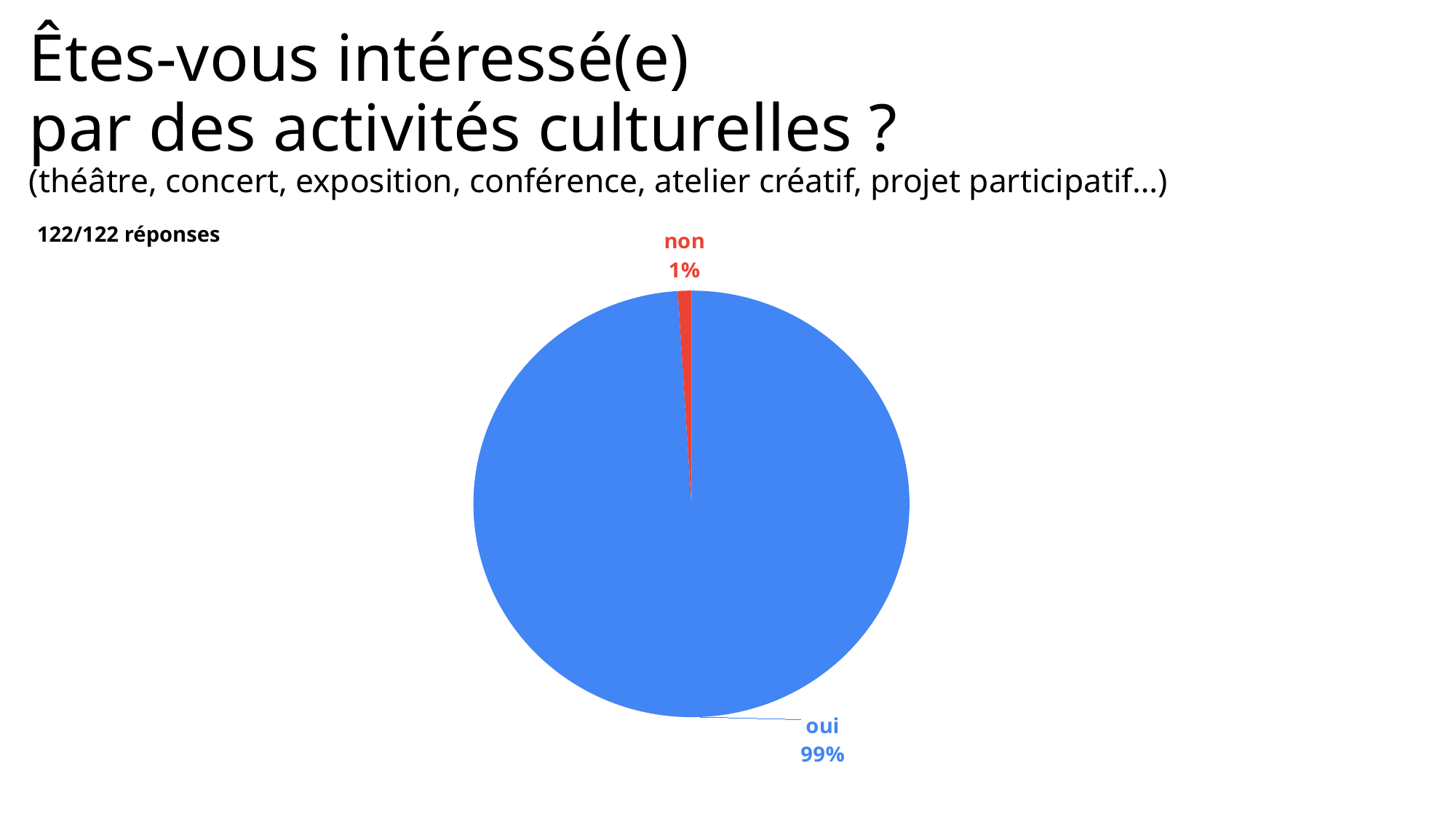
Which is larger, the "oui" slice or the "non" slice? oui Which slice of the pie is the largest? oui How many slices does the pie chart have? 2 What share of the pie does the "oui" slice represent? 99% What share of the pie does the "non" slice represent? 1% How many responses does the slide say the chart is based on? 122/122 réponses What is the difference in percentage points between the "oui" and "non" slices? 98 Which slice of the pie is the smallest? non What colour is the "non" slice? red What kind of chart is shown on the slide? pie chart